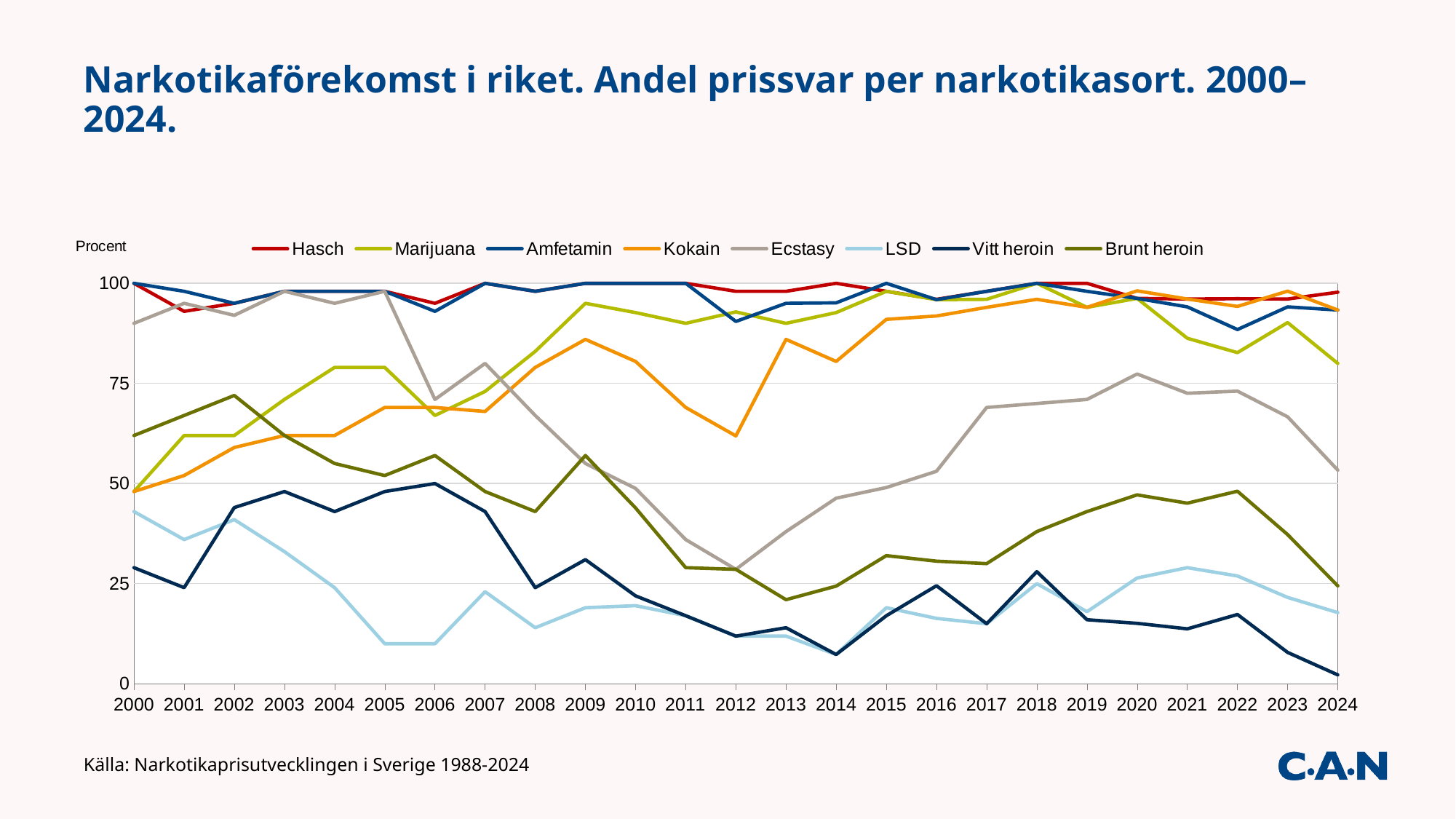
Which series is drawn in red in the legend? Hasch Which series has the lowest value in 2024? Vitt heroin How many series does the legend list? 8 Does the Vitt heroin line rise or fall from 2018 to 2024? fall Is the value for Brunt heroin in 2002 greater or less than 50? greater In 2024, which is larger: Marijuana or Ecstasy? Marijuana What is the label on the y axis? Procent Is the value for Kokain in 2012 greater or less than 75? less What is the value for Hasch in 2000? 100 How many years are shown along the x axis? 25 Is the value for Ecstasy in 2012 greater or less than 50? less What kind of chart is shown on the slide? line chart